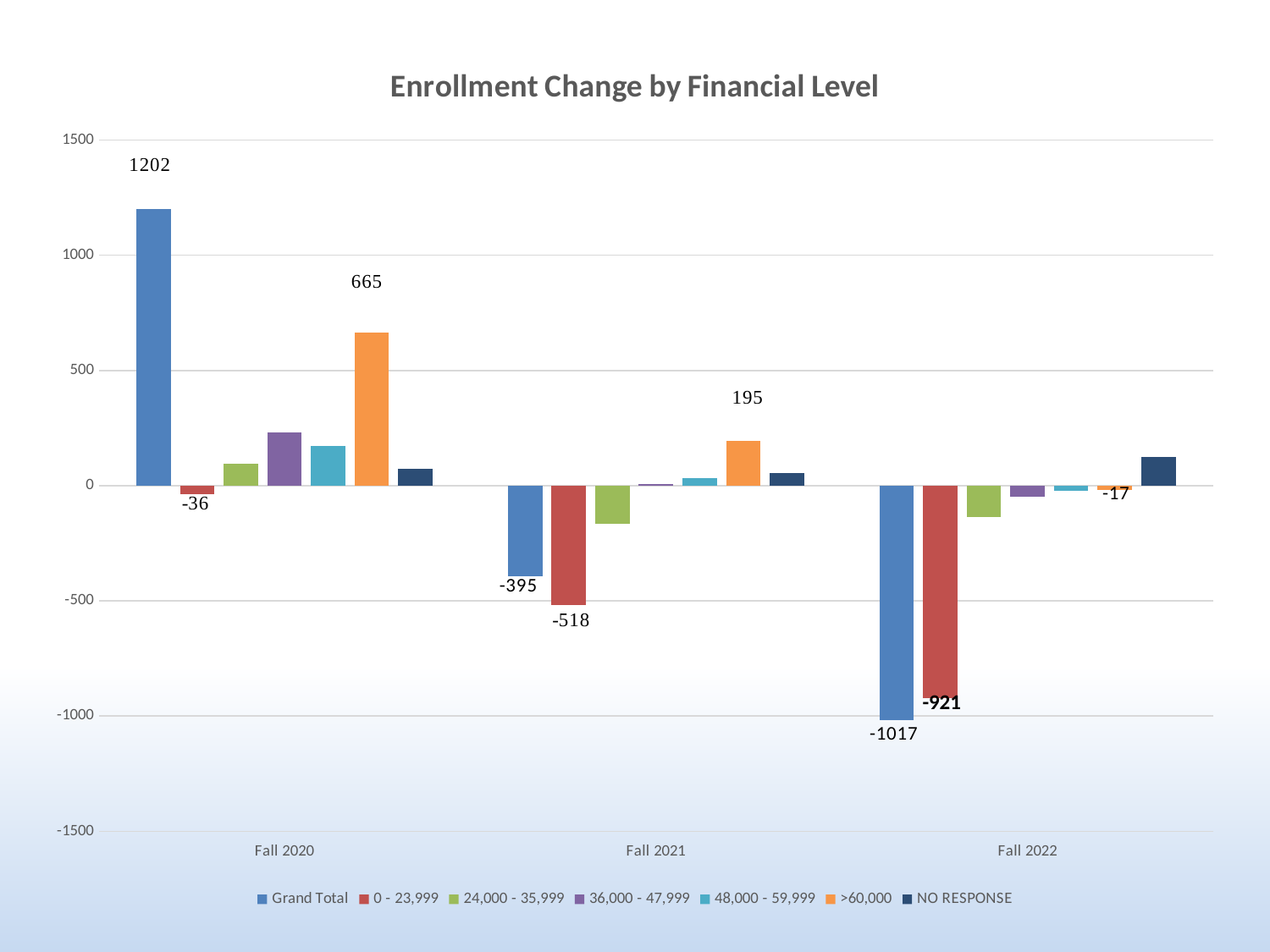
Is the value for the 36,000 - 47,999 series in Fall 2020 greater or less than 500? less How many series does the legend list? 7 Does the Grand Total value rise or fall from Fall 2020 to Fall 2022? fall What is the Grand Total enrollment change for Fall 2022? -1017 What is the value for the 0 - 23,999 series in Fall 2022? -921 What is the difference between the Grand Total values for Fall 2020 and Fall 2022? 2219 What kind of chart is shown on the slide? bar chart In Fall 2021, which is larger: the Grand Total value or the 0 - 23,999 value? Grand Total What is the Grand Total enrollment change for Fall 2020? 1202 What is the value for the >60,000 series in Fall 2021? 195 How many categories are shown on the x axis? 3 What is the difference between the >60,000 values for Fall 2020 and Fall 2021? 470